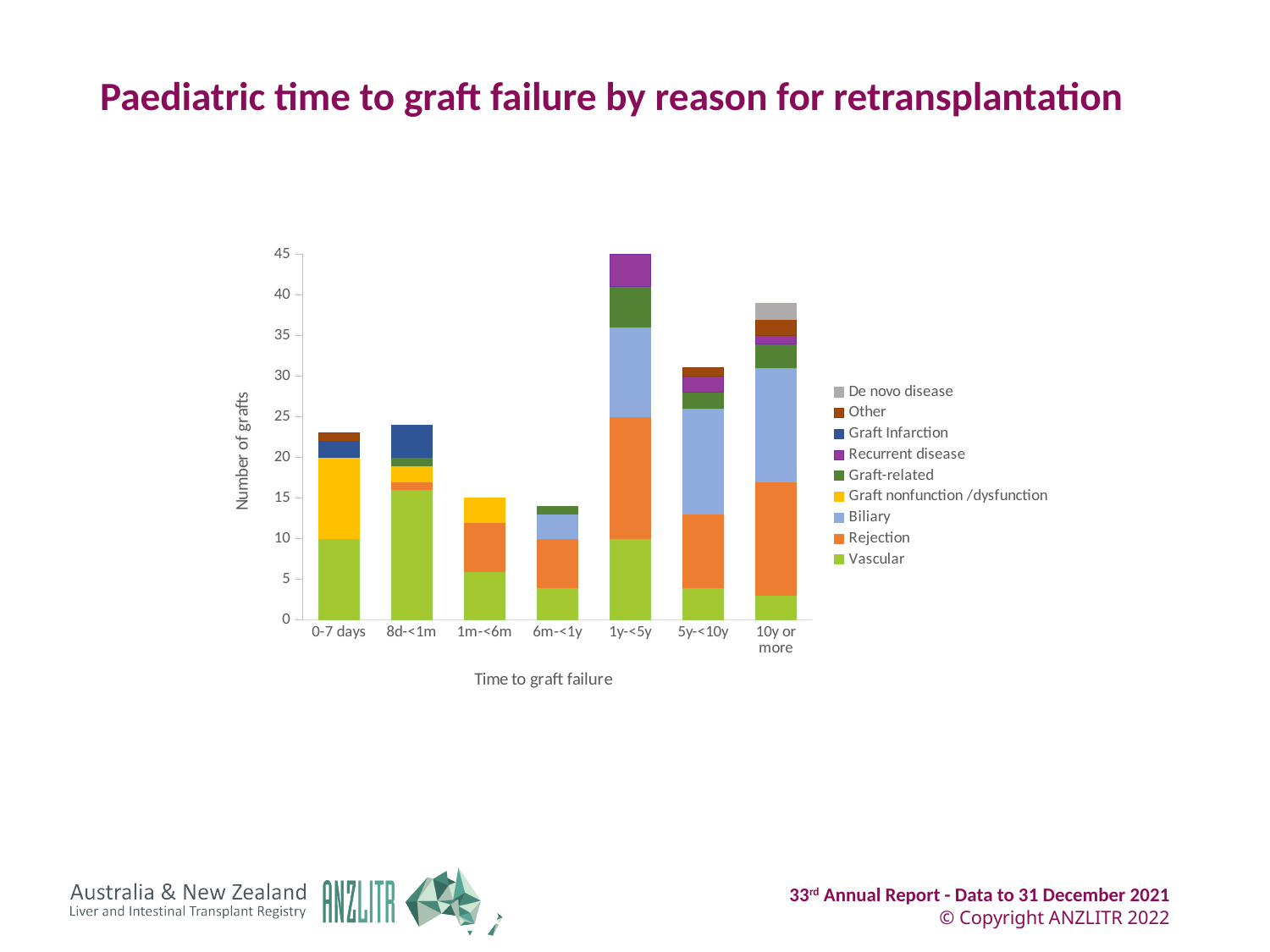
Is the total number of grafts for the 10y or more category greater or less than 35? greater Which has a larger total number of grafts, the 1y-<5y category or the 10y or more category? 1y-<5y What kind of chart is shown on the slide? Stacked bar chart Is the total number of grafts for the 5y-<10y category greater or less than 30? greater What is the total number of grafts for the 1m-<6m category? 15 How many time-to-graft-failure categories are shown on the x axis? 7 How many series does the legend list? 9 Which time-to-graft-failure category has the highest total number of grafts? 1y-<5y What is the label of the y axis? Number of grafts Is the total number of grafts for the 8d-<1m category greater or less than 25? less What is the title of the chart? Paediatric time to graft failure by reason for retransplantation